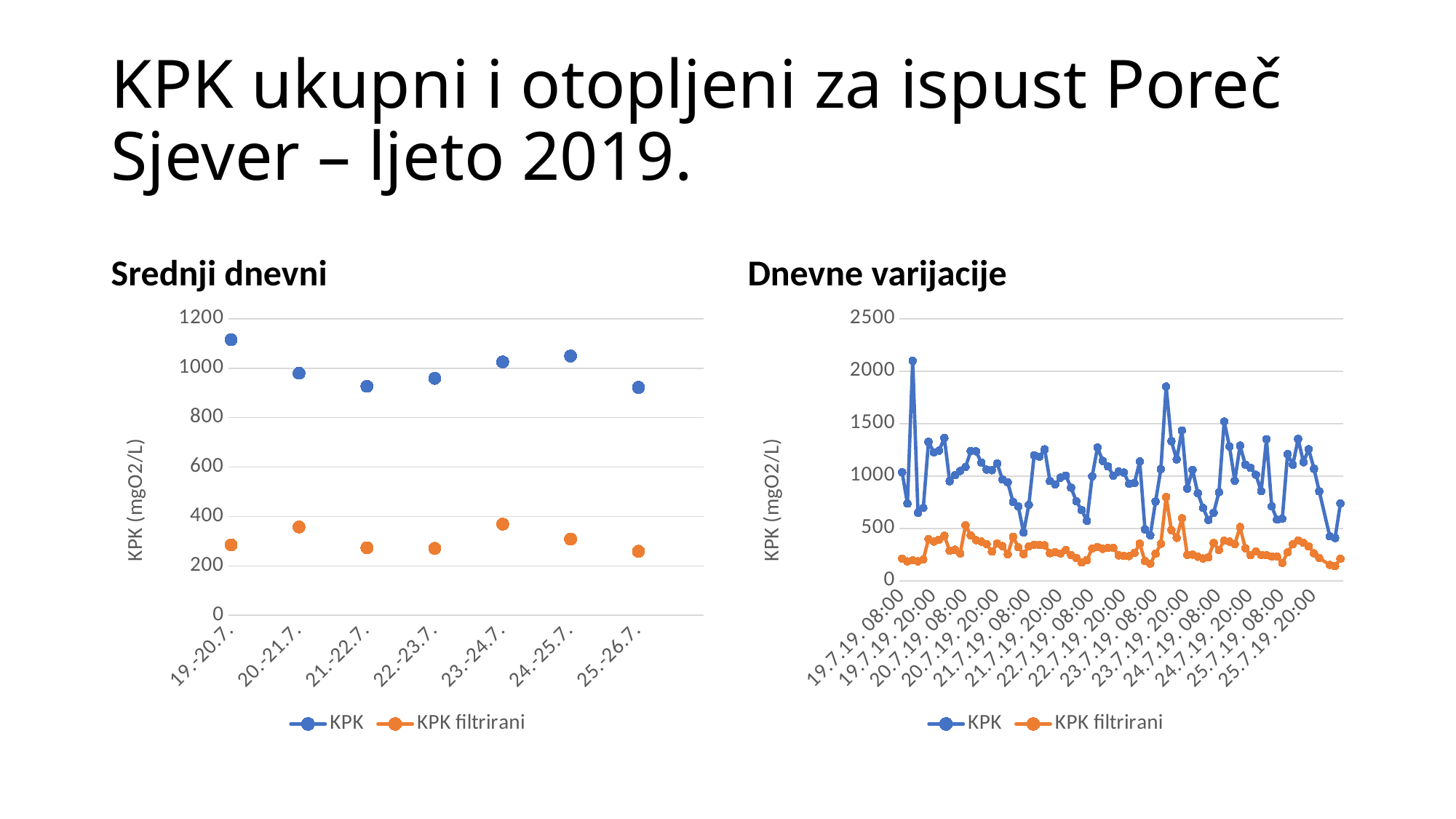
On the 'Srednji dnevni' chart, is the KPK value for 21.-22.7. greater or less than 1000? less What kind of chart is 'Dnevne varijacije'? line chart On the 'Srednji dnevni' chart, which is larger for 23.-24.7., KPK or KPK filtrirani? KPK On the 'Srednji dnevni' chart, how many series does the legend list? 2 What is the y-axis label on the 'Dnevne varijacije' chart? KPK (mgO2/L) On the 'Srednji dnevni' chart, how many categories are shown on the x axis? 7 On the 'Dnevne varijacije' chart, how many series does the legend list? 2 On the 'Srednji dnevni' chart, which category has the highest KPK value? 19.-20.7. On the 'Srednji dnevni' chart, which is larger, the KPK value for 19.-20.7. or the KPK value for 21.-22.7.? 19.-20.7. On the 'Dnevne varijacije' chart, is the highest KPK value greater or less than 2000? greater On the 'Srednji dnevni' chart, is the KPK filtrirani value for 20.-21.7. greater or less than 400? less